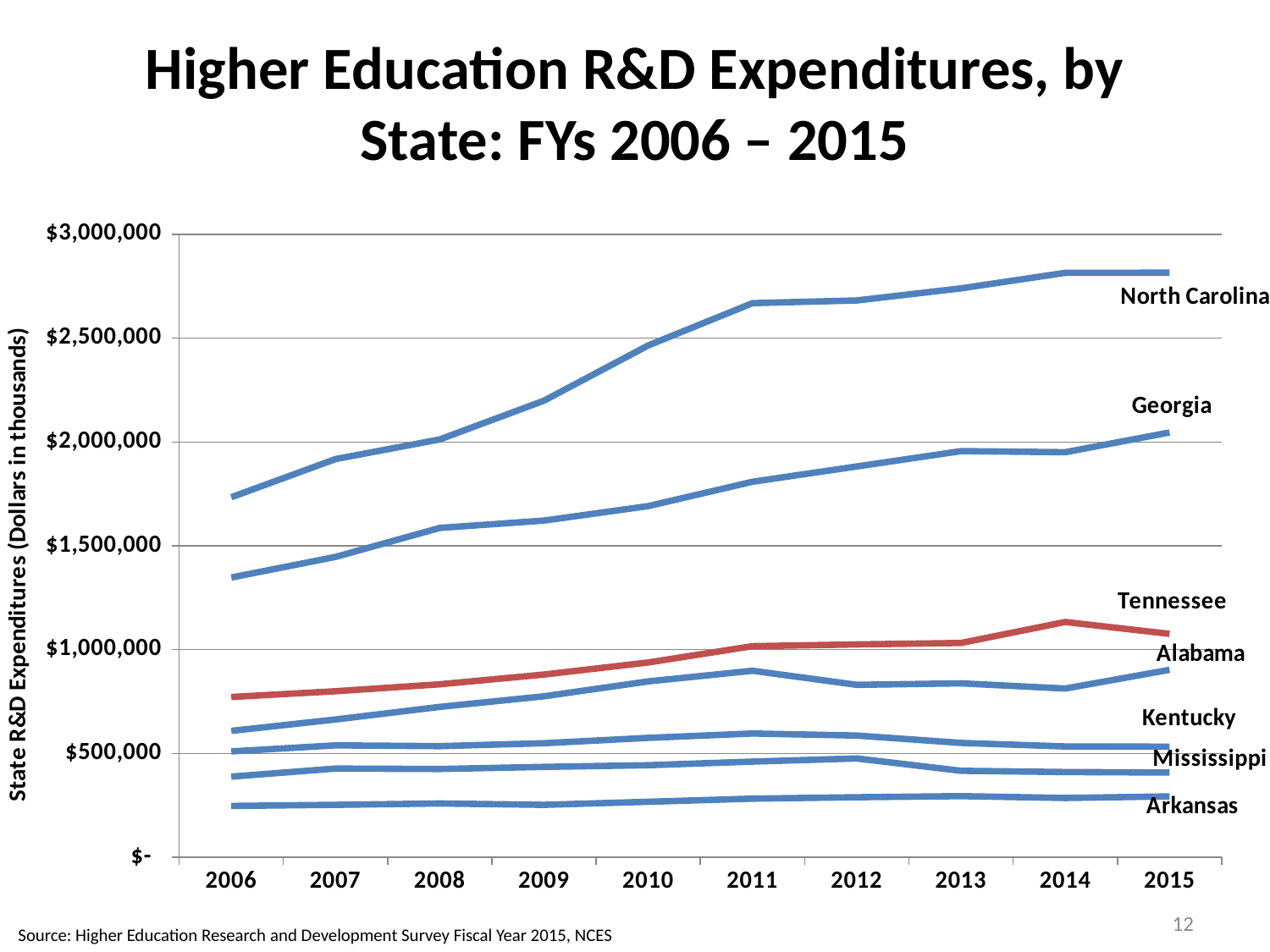
Is the value for Mississippi in 2013 greater or less than $500,000? less Which state had higher expenditures in 2010, Georgia or Tennessee? Georgia How many fiscal years are shown along the x axis? 10 Which state has the lowest higher education R&D expenditures in 2015? Arkansas How many states are plotted as lines on the chart? 7 Which state has the highest higher education R&D expenditures in 2015? North Carolina Do North Carolina's expenditures generally rise or fall from 2006 to 2015? rise Is the value for Georgia in 2006 greater or less than $1,500,000? less Is the value for North Carolina in 2015 greater or less than $2,500,000? greater What kind of chart is shown on the slide? line chart Which state's line is drawn in red? Tennessee